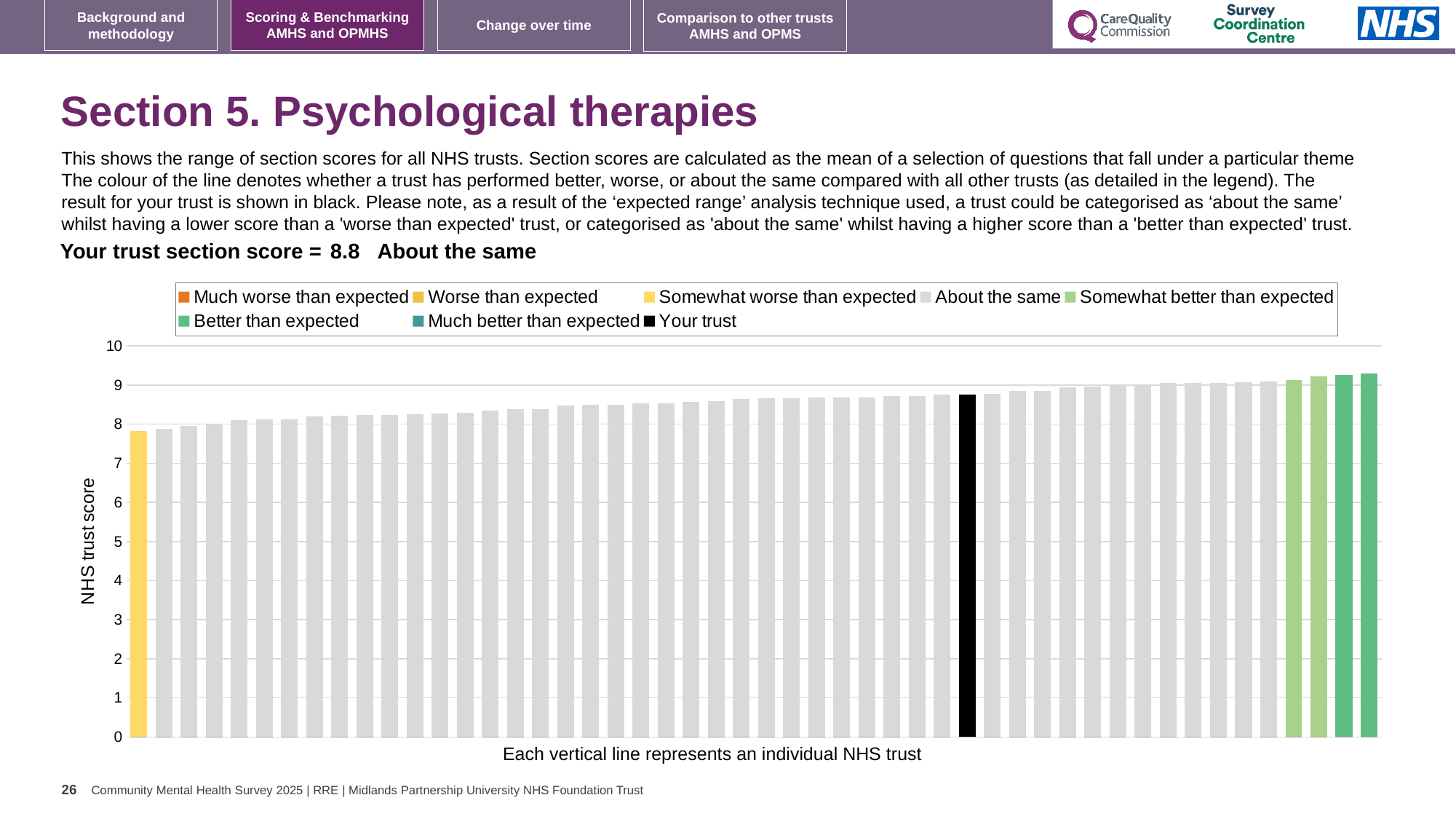
What is the highest value shown on the vertical axis? 10 Is the value for the leftmost (lowest) bar greater or less than 7? greater How many entries does the chart legend list? 8 Which is larger, the value of the black 'Your trust' bar or the value of the leftmost bar? The black 'Your trust' bar What benchmark category is your trust placed in for this section? About the same What is the label on the vertical axis of the chart? NHS trust score What kind of chart is shown on the slide? Bar chart Is the value for the black 'Your trust' bar greater or less than 8? greater What is the section score for your trust shown on the slide? 8.8 Is the value for the rightmost (highest) bar greater or less than 9? greater Do the bar values rise or fall from left to right along the x axis? Rise